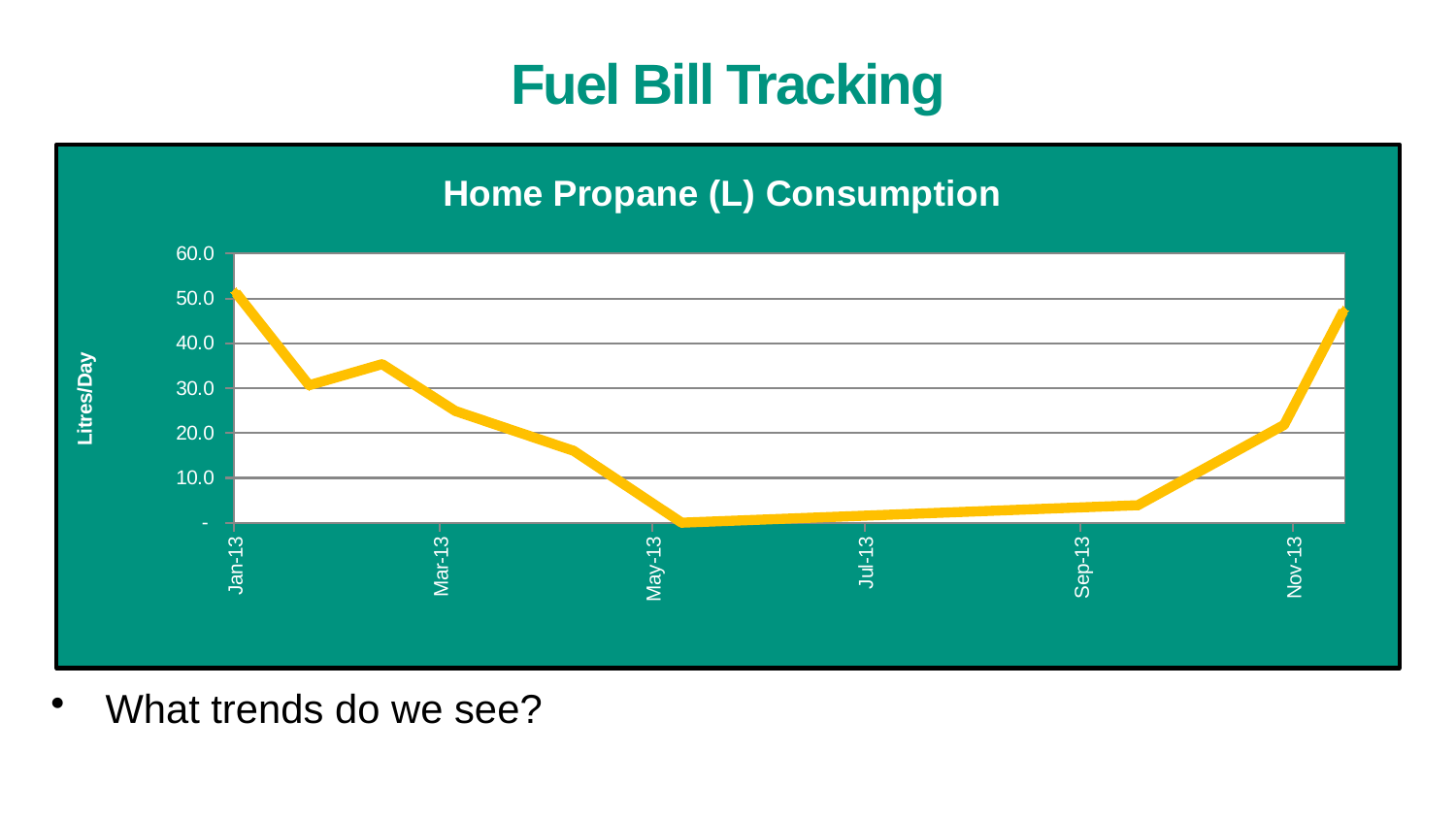
Which labelled month on the x axis has the highest propane consumption? Jan-13 Which is larger, the value for Jan-13 or the value for Sep-13? Jan-13 Is the value for Mar-13 greater or less than 30? greater Is the value for Jan-13 greater or less than 40? greater Is the value for Nov-13 greater or less than 10? greater What is the title of the chart? Home Propane (L) Consumption How does propane consumption change from Jan-13 to May-13? It falls What is the label on the vertical axis of the chart? Litres/Day Which labelled month on the x axis has the lowest propane consumption? Jul-13 What kind of chart is shown on the slide? line chart